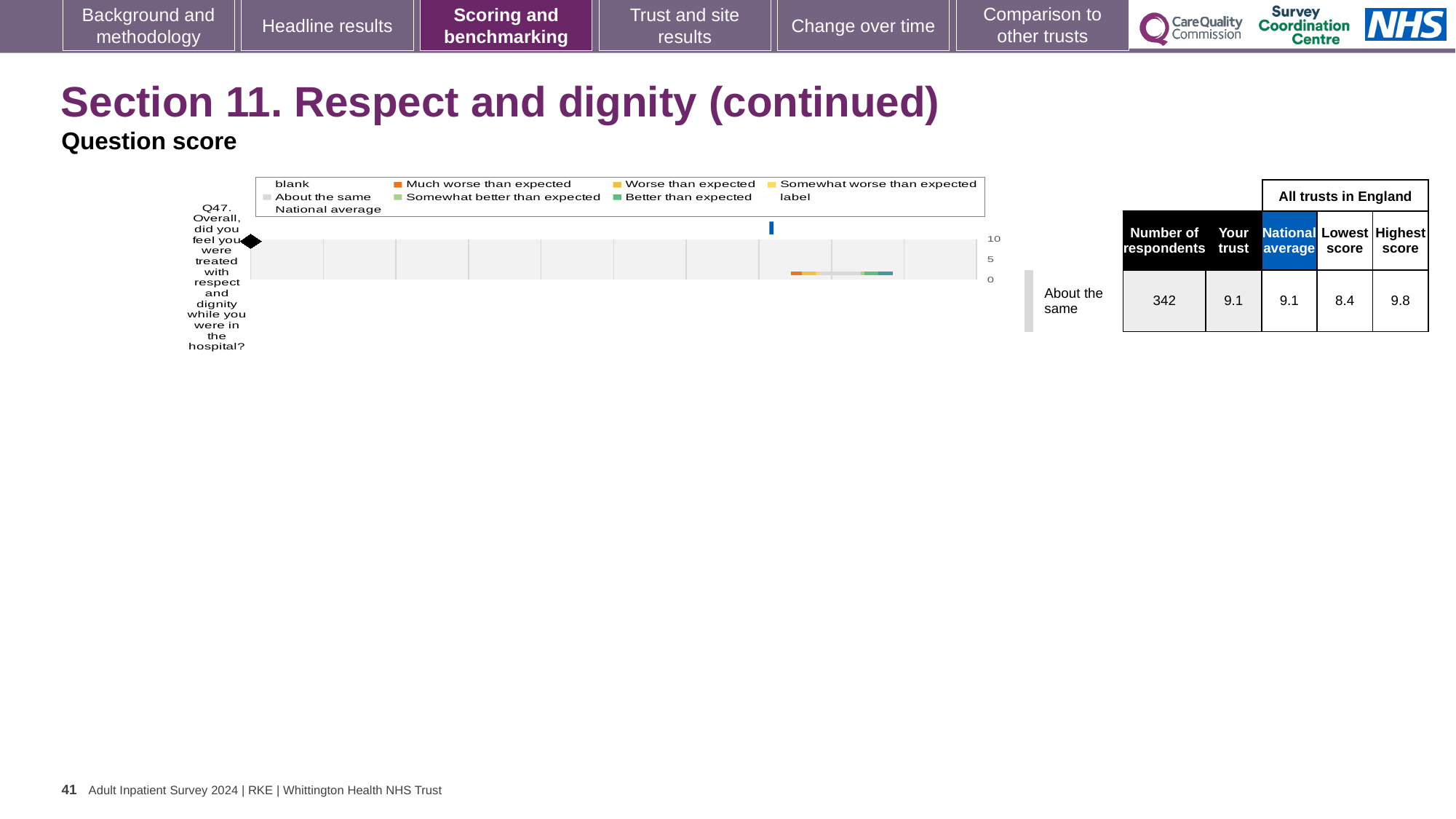
What is the difference between the highest score (9.8) and the lowest score (8.4) for Q47 in the table beside the chart? 1.4 How many questions are plotted in the chart? 1 Which question number is plotted in the chart? Q47 According to the table beside the chart, what is the highest score among all trusts in England for Q47? 9.8 According to the table beside the chart, what is the national average score for Q47? 9.1 How many entries does the chart legend list? 9 According to the table beside the chart, what is the 'Your trust' score for Q47? 9.1 What kind of chart is used to show the Q47 question score? bar chart What is the highest tick value shown on the chart's score axis? 10 Is the 'Your trust' score for Q47 higher than, lower than, or the same as the national average in the table beside the chart? the same According to the table beside the chart, what is the lowest score among all trusts in England for Q47? 8.4 According to the table beside the chart, how many respondents answered Q47? 342